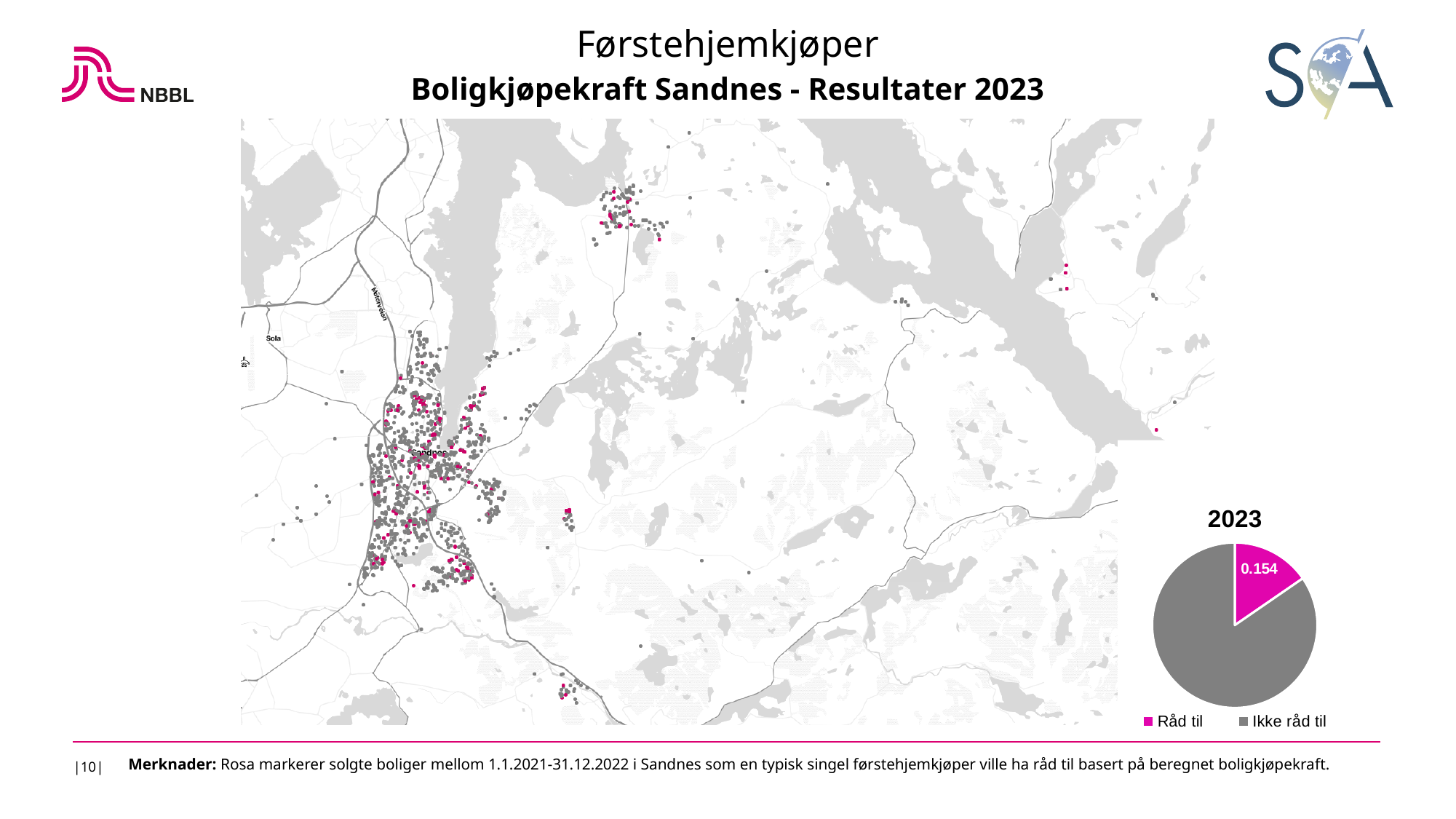
In the pie chart titled 2023, what value is shown for the Råd til slice? 0.154 How many slices does the pie chart titled 2023 have? 2 What is the title of the pie chart on the slide? 2023 In the pie chart titled 2023, which slice is larger: Råd til or Ikke råd til? Ikke råd til How many entries does the legend of the pie chart list? 2 What kind of chart is shown in the bottom right of the slide? Pie chart In the pie chart titled 2023, which category has the smallest slice? Råd til In the pie chart titled 2023, which category has the largest slice? Ikke råd til In the pie chart titled 2023, what share of the pie does the Råd til slice represent? 0.154 In the pie chart, what colour is the Råd til slice? Pink